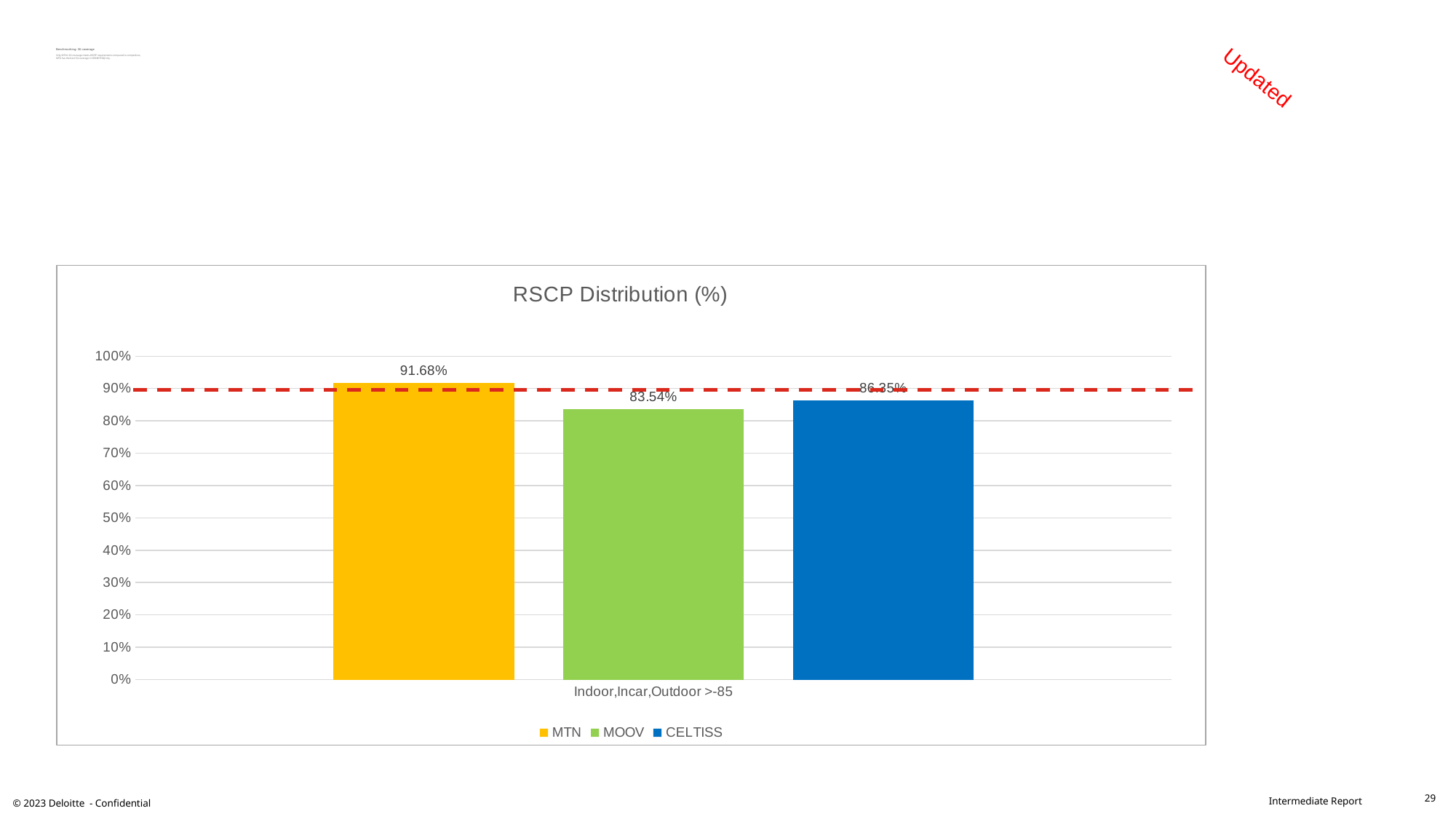
At what level on the y axis is the red dashed line drawn in the RSCP Distribution (%) chart? 90% What kind of chart is shown on the slide? bar chart Which is larger in the RSCP Distribution (%) chart, the value for MTN or the value for CELTISS? MTN How many series does the legend of the RSCP Distribution (%) chart list? 3 What is the value for MTN in the RSCP Distribution (%) chart? 91.68% What is the title of the chart on the slide? RSCP Distribution (%) Which operator has the highest value in the RSCP Distribution (%) chart? MTN What is the difference between the MTN and MOOV values in the RSCP Distribution (%) chart? 8.14% What is the value for MOOV in the RSCP Distribution (%) chart? 83.54% Which operator has the lowest value in the RSCP Distribution (%) chart? MOOV Is the value for MOOV greater or less than 80%? greater Is the value for CELTISS greater or less than 90%? less